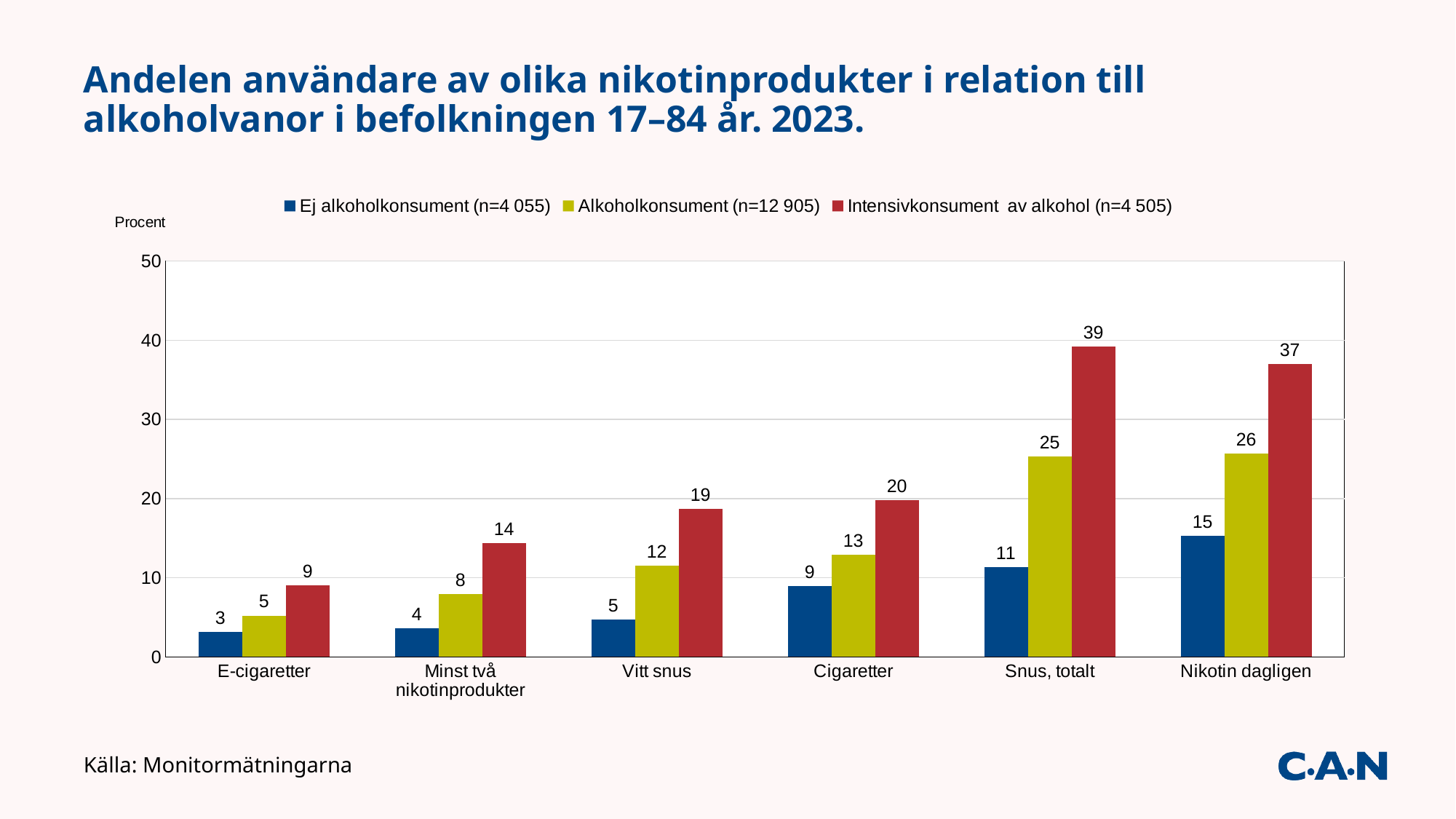
How many series does the legend list? 3 Which is larger for Minst två nikotinprodukter: the Alkoholkonsument value or the Intensivkonsument av alkohol value? Intensivkonsument av alkohol What is the source given at the bottom of the slide? Monitormätningarna What kind of chart is shown on the slide? Bar chart What is the value for Alkoholkonsument for Vitt snus? 12 Is the value for Intensivkonsument av alkohol for Nikotin dagligen greater or less than 30? greater Which category has the highest value for Intensivkonsument av alkohol? Snus, totalt What is the difference between the Intensivkonsument av alkohol and Ej alkoholkonsument values for Cigaretter? 11 How many categories are shown on the x axis? 6 What is the value for Intensivkonsument av alkohol for Snus, totalt? 39 Which category has the lowest value for Ej alkoholkonsument? E-cigaretter What is the value for Ej alkoholkonsument for Nikotin dagligen? 15